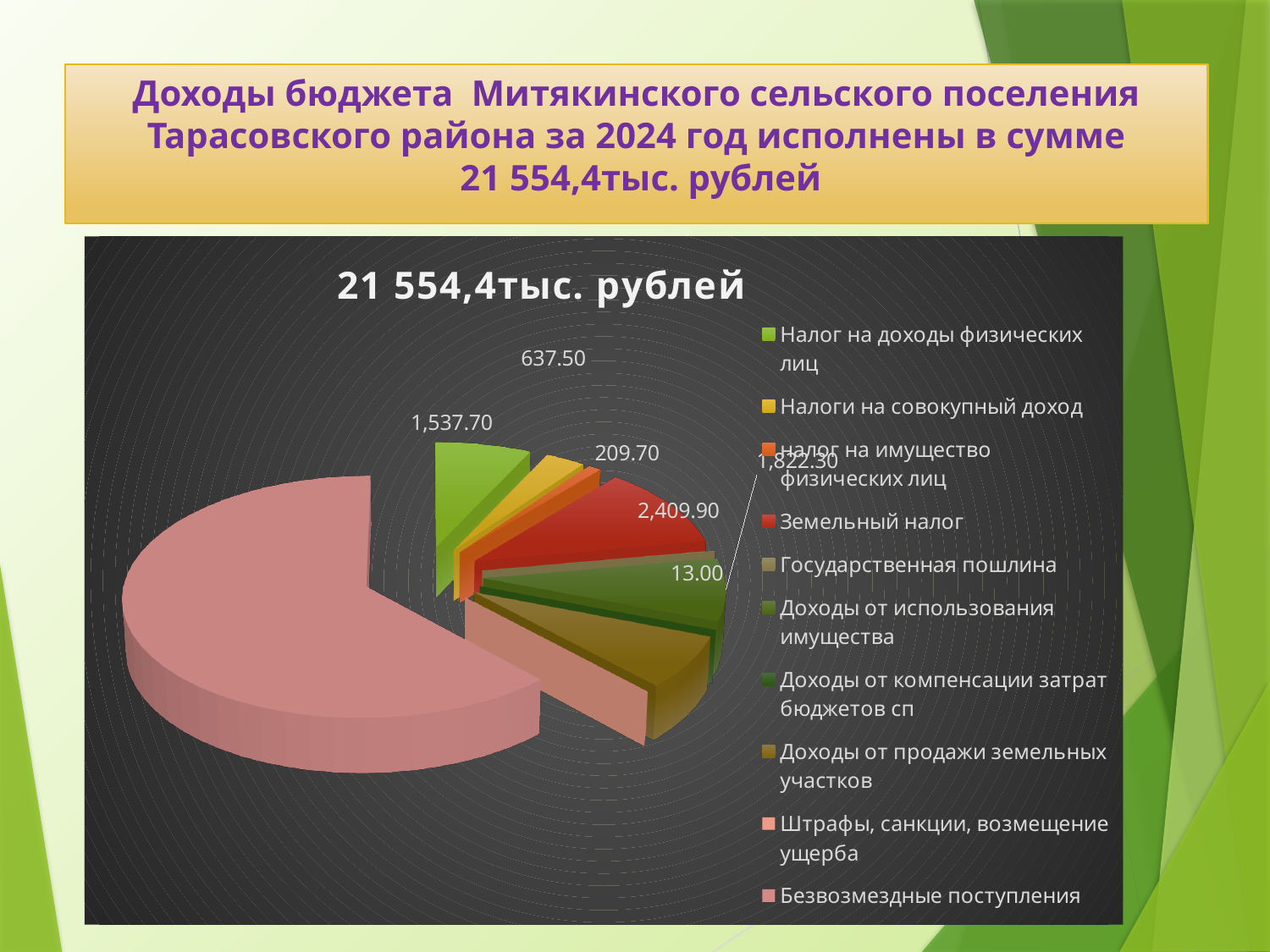
What is the value shown for Земельный налог? 2,409.90 What is the value shown for Налог на доходы физических лиц? 1,537.70 What is the difference between Земельный налог and налог на имущество физических лиц? 2,200.20 Which is larger, Земельный налог or Налог на доходы физических лиц? Земельный налог What colour is the slice for Безвозмездные поступления? Pink What is the title of the chart? 21 554,4тыс. рублей How many categories does the chart legend list? 10 What is the value shown for налог на имущество физических лиц? 209.70 What is the difference between Земельный налог and Налог на доходы физических лиц? 872.20 What kind of chart is shown on the slide? Pie chart Which category has the largest slice of the pie? Безвозмездные поступления